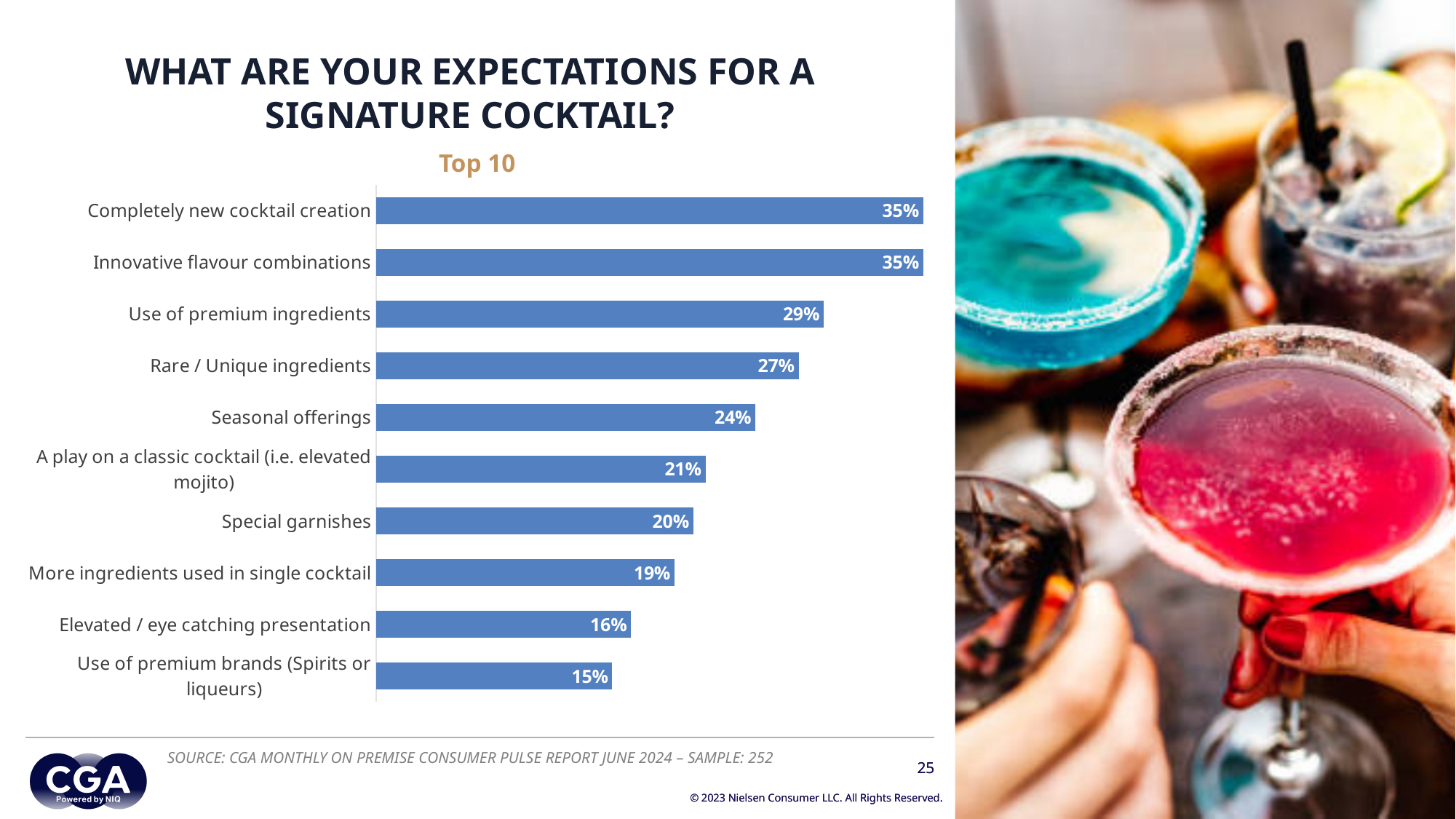
Which category has the lowest value in the chart? Use of premium brands (Spirits or liqueurs) Which is larger: 'Seasonal offerings' or 'More ingredients used in single cocktail'? Seasonal offerings What is the value shown for 'Special garnishes'? 20% What is the subtitle shown above the chart? Top 10 What is the value shown for 'Seasonal offerings'? 24% What is the value shown for 'Elevated / eye catching presentation'? 16% What kind of chart is shown on the slide? Bar chart How many categories are shown in the chart? 10 What is the difference between 'Completely new cocktail creation' and 'Use of premium brands (Spirits or liqueurs)'? 20% What is the difference between 'Use of premium ingredients' and 'Rare / Unique ingredients'? 2% What is the highest value shown in the chart? 35% What percentage of respondents expect 'Use of premium ingredients' from a signature cocktail? 29%